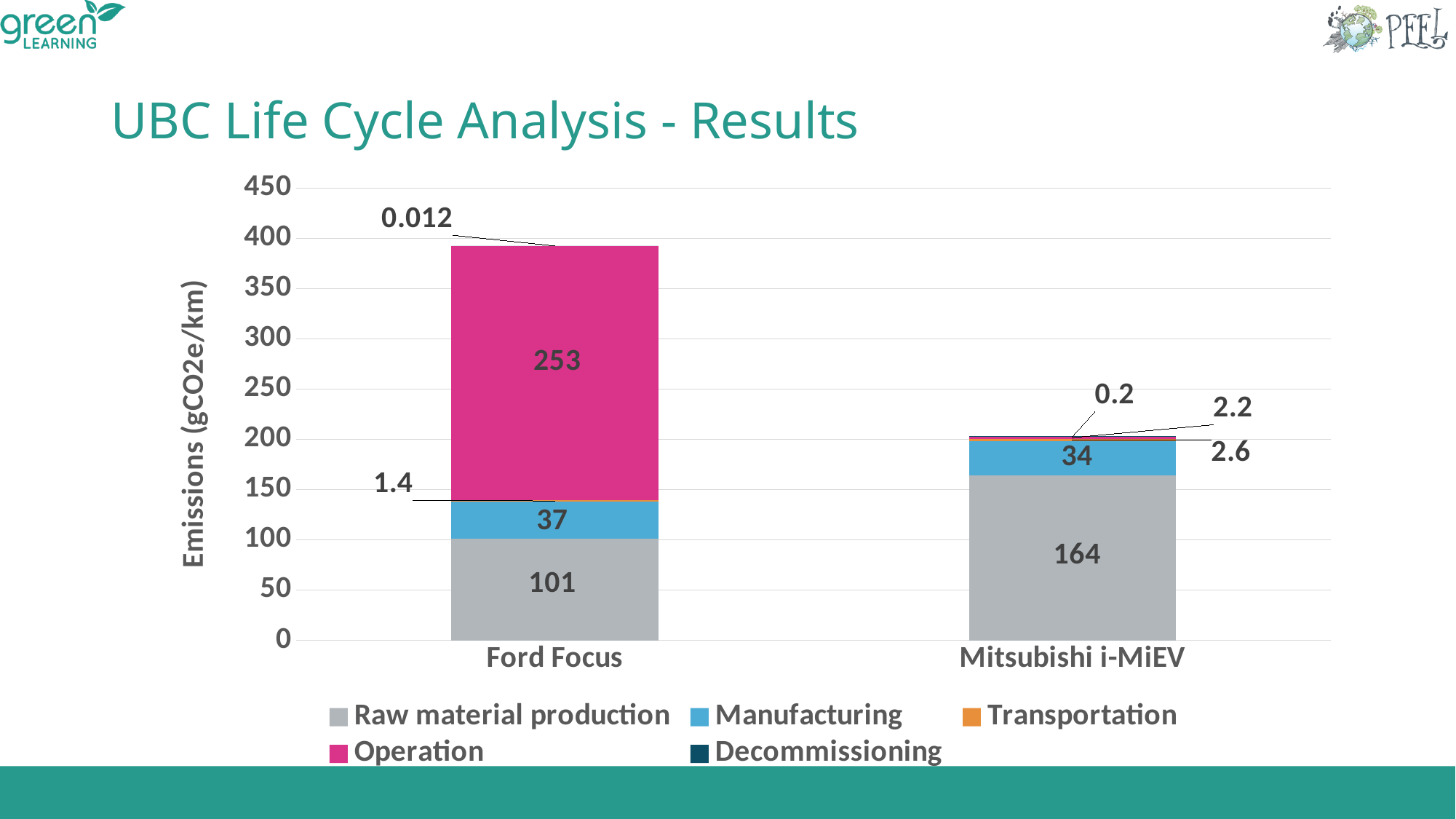
Is the total bar height for the Ford Focus greater or less than 350? greater What is the Raw material production value for the Mitsubishi i-MiEV? 164 How many vehicles (categories) are plotted on the x axis? 2 Which vehicle has the highest total emissions? Ford Focus What is the Manufacturing value for the Ford Focus? 37 How many series does the legend list? 5 What is the Decommissioning value labelled for the Ford Focus? 0.012 What is the Operation emissions value for the Ford Focus? 253 What kind of chart is shown on the slide? Stacked bar chart Which vehicle has the larger Manufacturing value, Ford Focus or Mitsubishi i-MiEV? Ford Focus What is the difference in Raw material production between the Mitsubishi i-MiEV and the Ford Focus? 63 What is the total stacked emissions value for the Mitsubishi i-MiEV? 203